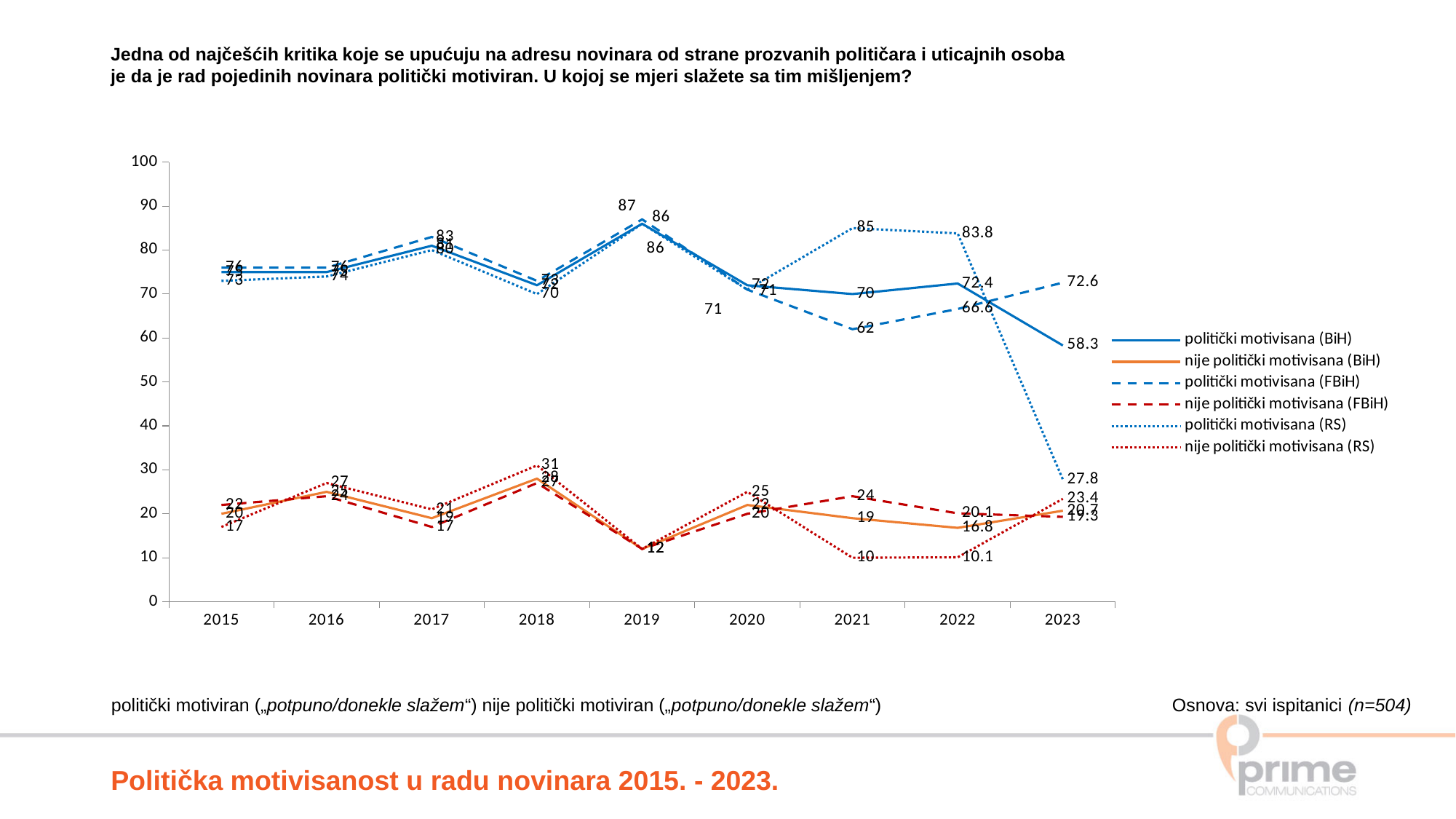
By how much did politički motivisana (RS) drop from 2022 to 2023? 56 What is the value for politički motivisana (RS) in 2022? 83.8 How many series does the legend list? 6 What is the value for politički motivisana (FBiH) in 2021? 62 What is the value for politički motivisana (BiH) in 2023? 58.3 In 2023, which is larger: politički motivisana (FBiH) or politički motivisana (BiH)? politički motivisana (FBiH) How many years are shown on the x axis? 9 What kind of chart is shown on the slide? line chart What is the value for politički motivisana (RS) in 2021? 85 What is the value for nije politički motivisana (FBiH) in 2021? 24 In which year is politički motivisana (FBiH) highest? 2019 In which year is politički motivisana (RS) lowest? 2023